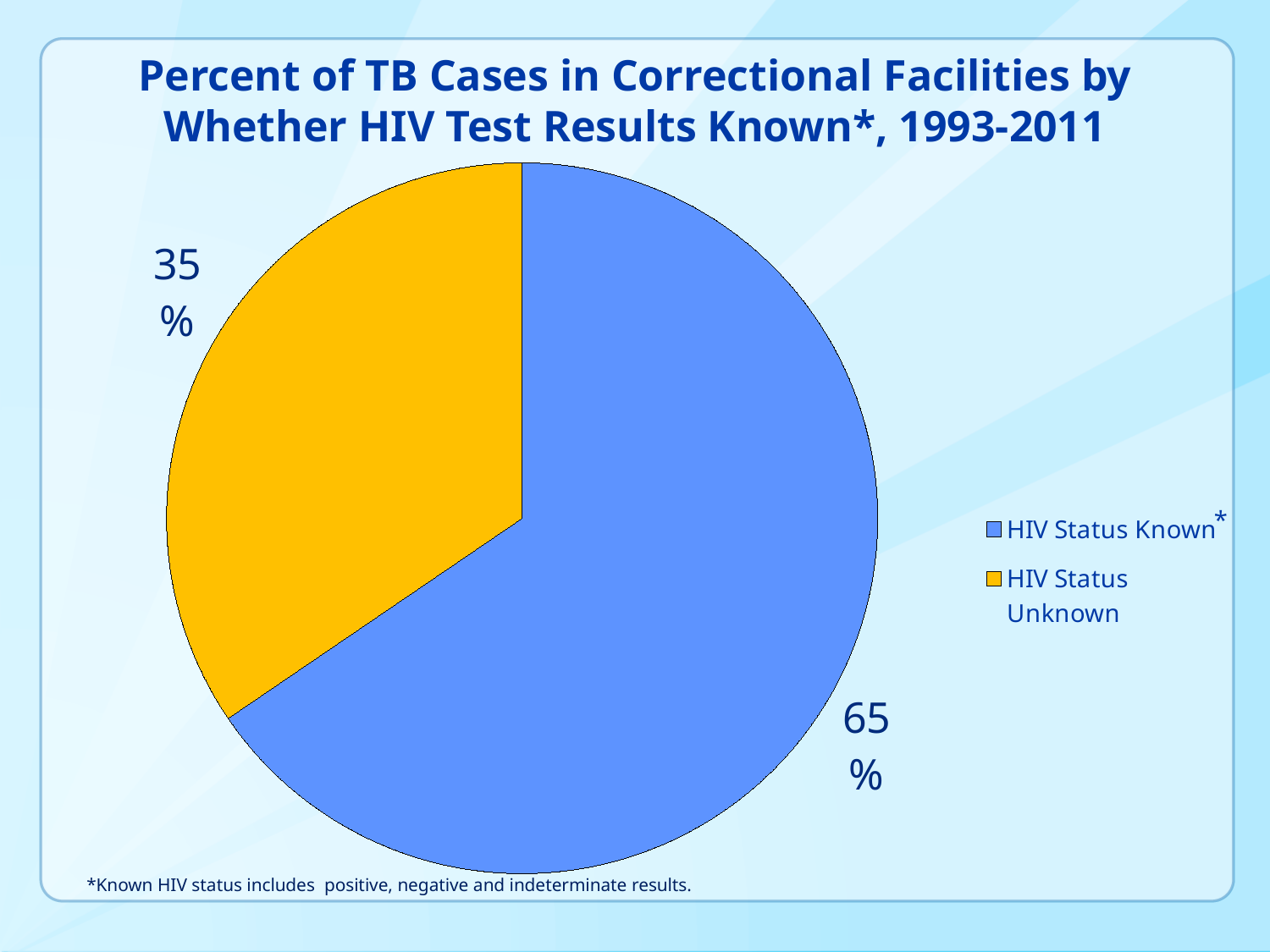
What colour is the HIV Status Known slice? blue What time period does the chart title cover? 1993-2011 Is the share for HIV Status Known larger or smaller than the share for HIV Status Unknown? larger What kind of chart is shown on the slide? pie chart What percentage of TB cases in correctional facilities had HIV status unknown? 35% Which category has the larger share of the pie? HIV Status Known How many slices does the pie chart have? 2 How many entries does the legend list? 2 Which category has the smaller share of the pie? HIV Status Unknown What is the difference in percentage points between HIV Status Known and HIV Status Unknown? 30 What percentage of TB cases in correctional facilities had HIV status known? 65% What share of the pie does the HIV Status Unknown slice represent? 35%